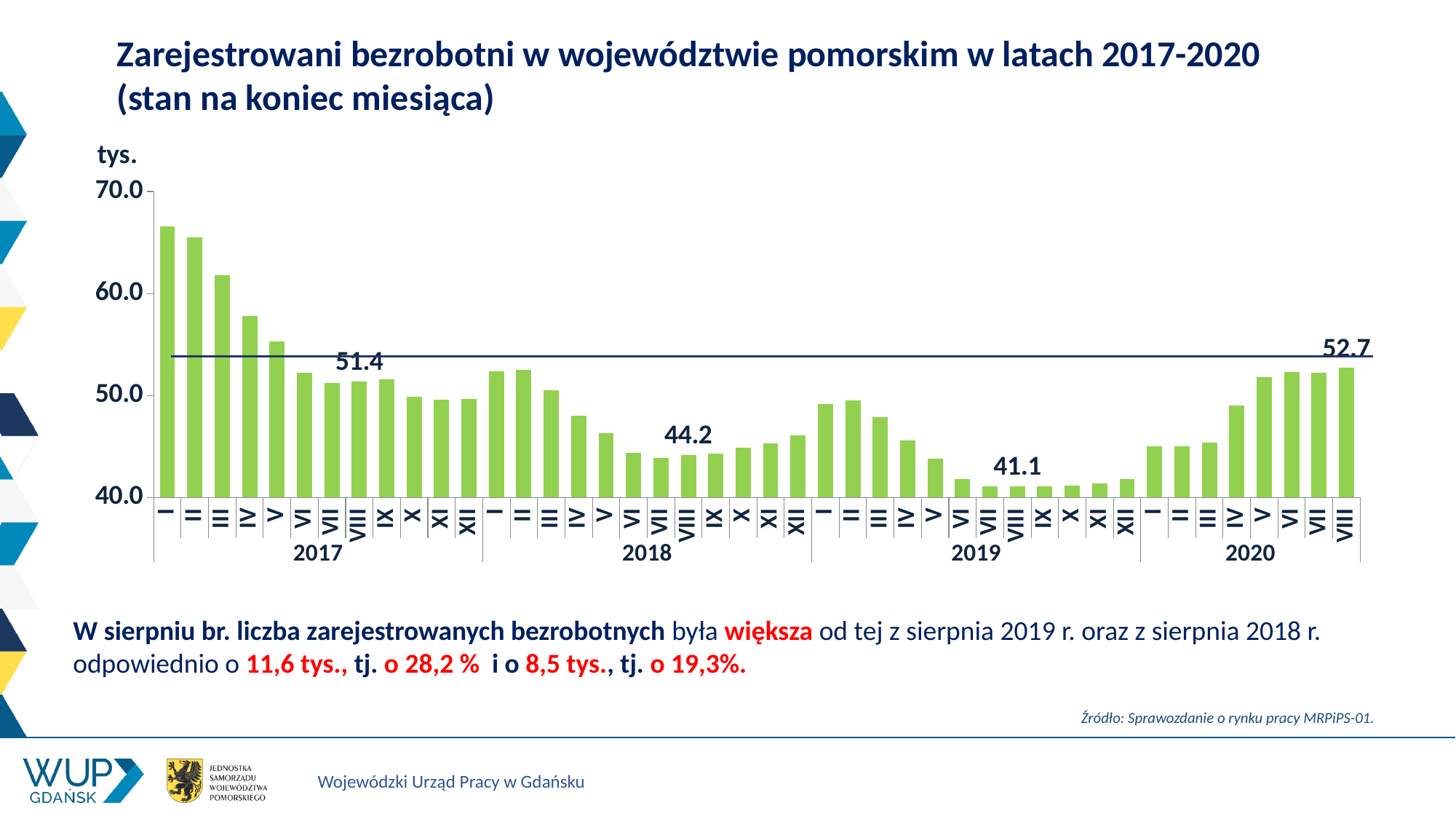
Which month has the highest value on the chart? I 2017 Is the value for I 2017 greater or less than 60.0? greater What is the value for VIII 2017? 51.4 What is the difference between the values for VIII 2020 and VIII 2018? 8.5 What is the value for VIII 2019? 41.1 Is the value for V 2017 greater or less than 60.0? less How many bars are plotted on the chart? 44 Which is larger, the value for VIII 2017 or the value for VIII 2020? VIII 2020 What is the value for VIII 2018? 44.2 What is the value for VIII 2020? 52.7 What kind of chart is shown on the slide? bar chart What is the difference between the values for VIII 2020 and VIII 2019? 11.6